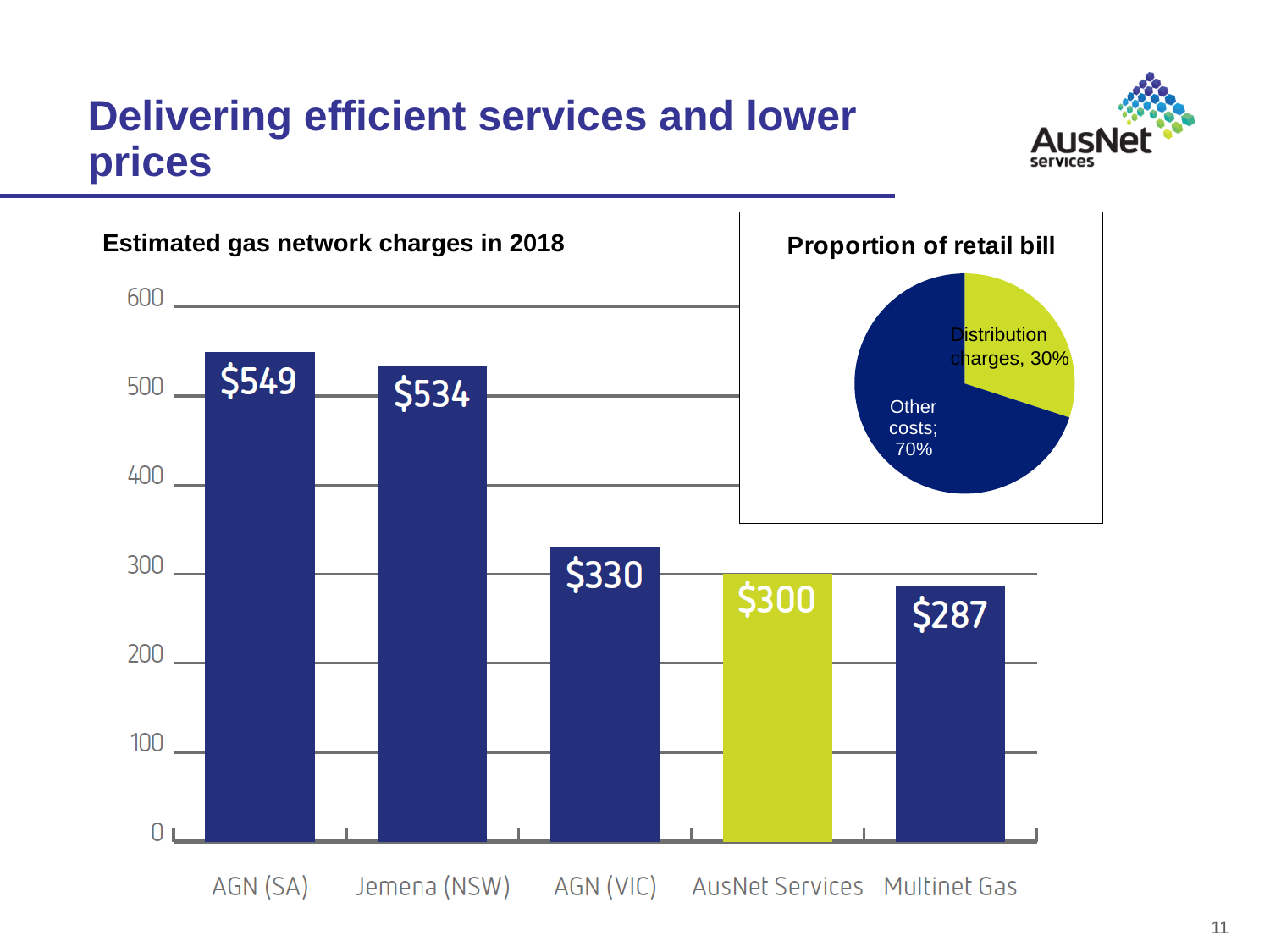
In the 'Estimated gas network charges in 2018' chart, what is the value for AusNet Services? $300 In the 'Estimated gas network charges in 2018' chart, what is the value for Jemena (NSW)? $534 What kind of chart is 'Proportion of retail bill'? pie chart In the 'Proportion of retail bill' chart, what share of the bill is Other costs? 70% In the 'Proportion of retail bill' chart, what share of the bill is Distribution charges? 30% In the 'Estimated gas network charges in 2018' chart, what is the difference between AGN (SA) and AusNet Services? $249 In the 'Estimated gas network charges in 2018' chart, which category has the highest value? AGN (SA) In the 'Estimated gas network charges in 2018' chart, which is larger, AGN (VIC) or Multinet Gas? AGN (VIC) In the 'Estimated gas network charges in 2018' chart, is the value for AGN (VIC) greater or less than 400? less What kind of chart is 'Estimated gas network charges in 2018'? bar chart How many categories are shown in the 'Estimated gas network charges in 2018' chart? 5 In the 'Estimated gas network charges in 2018' chart, which category has the lowest value? Multinet Gas